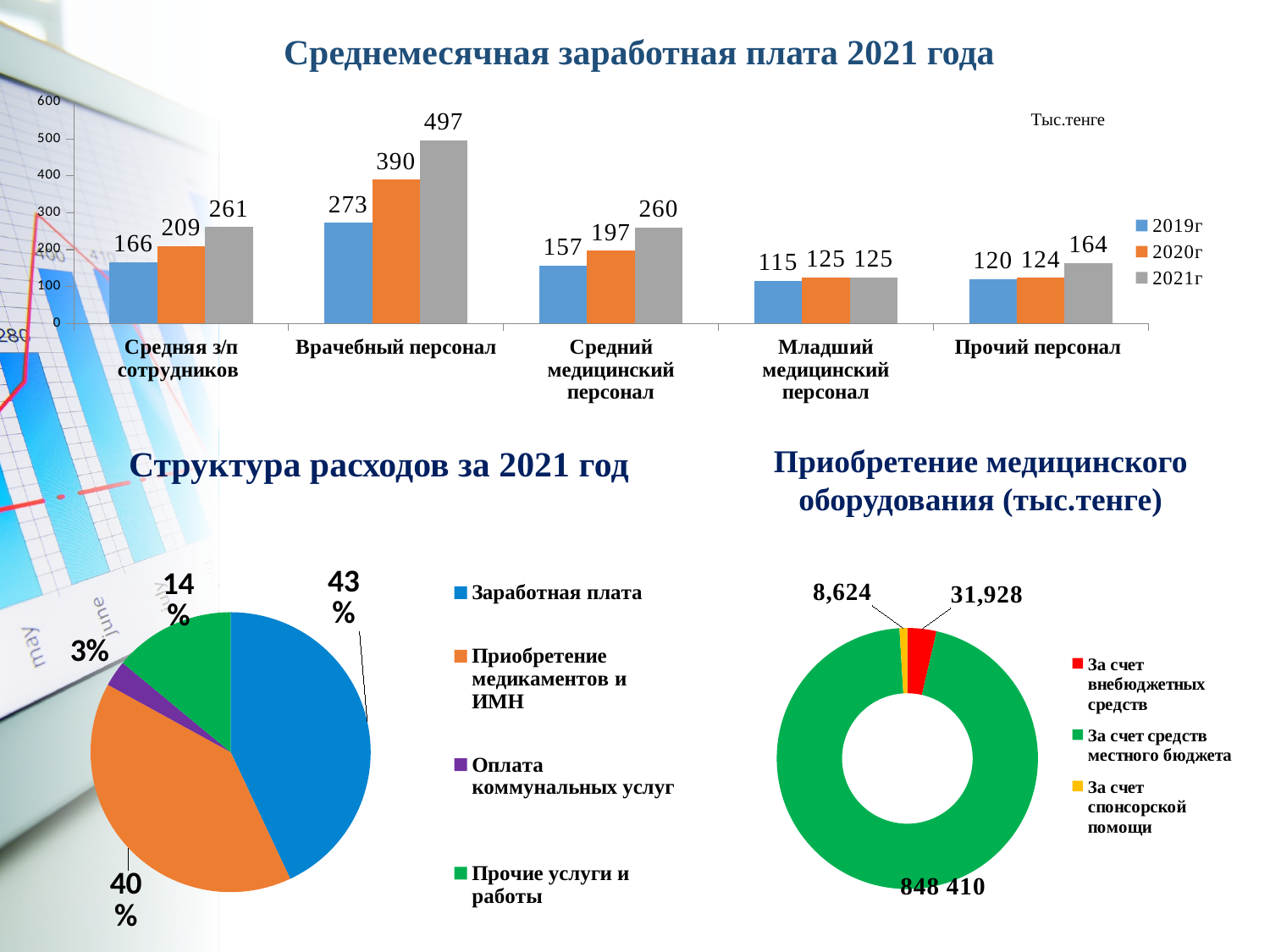
In the chart 'Среднемесячная заработная плата 2021 года', how many series does the legend list? 3 In the chart 'Среднемесячная заработная плата 2021 года', what is the difference between the 2021г and 2019г values for Средняя з/п сотрудников? 95 In the chart 'Среднемесячная заработная плата 2021 года', what is the value for Младший медицинский персонал in 2019г? 115 In the chart 'Среднемесячная заработная плата 2021 года', what is the value for Врачебный персонал in 2021г? 497 What kind of chart is 'Приобретение медицинского оборудования (тыс.тенге)'? doughnut chart In the chart 'Структура расходов за 2021 год', what share does Заработная плата have? 43% In the chart 'Среднемесячная заработная плата 2021 года', how many categories are shown on the x axis? 5 In the chart 'Среднемесячная заработная плата 2021 года', which category has the lowest value in 2019г? Младший медицинский персонал In the chart 'Структура расходов за 2021 год', which category has the smallest slice? Оплата коммунальных услуг In the chart 'Среднемесячная заработная плата 2021 года', which category has the highest value in 2021г? Врачебный персонал In the chart 'Среднемесячная заработная плата 2021 года', do the values for Прочий персонал rise or fall from 2019г to 2021г? rise In the chart 'Приобретение медицинского оборудования (тыс.тенге)', what is the value for За счет внебюджетных средств? 31,928